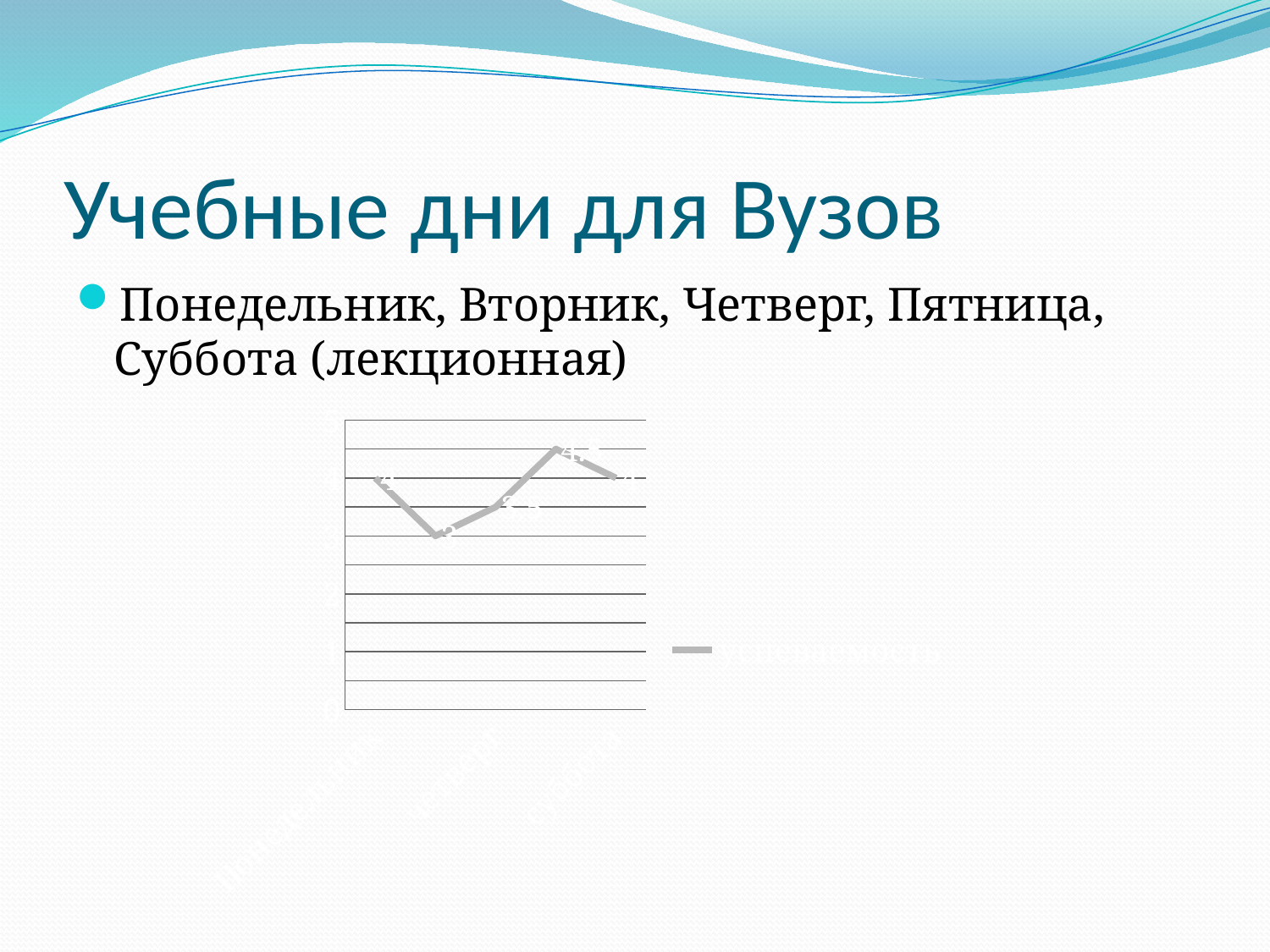
How many series does the chart's legend list? 1 Which is larger in the chart, the value for четверг or the value for суббота? суббота What is the name of the series shown in the chart's legend? успеваемость Which is larger in the chart, the value for понедельник or the value for четверг? понедельник How many data points are plotted on the line in the chart? 5 What kind of chart is shown on the slide? line chart